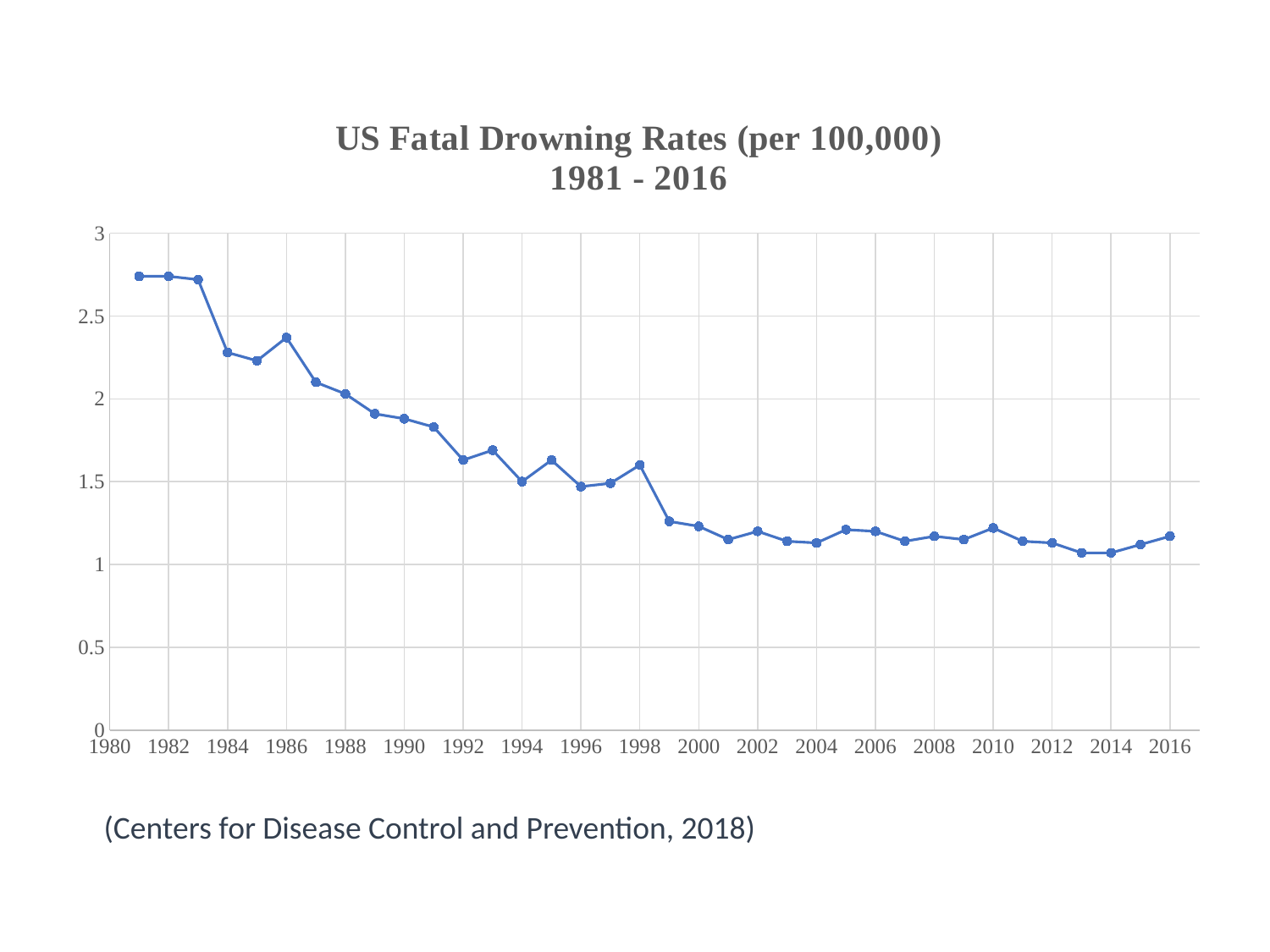
Which year has the larger value, 1981 or 2016? 1981 Is the value for 2014 greater or less than 1? greater What kind of chart is shown on the slide? line chart How many data points are plotted on the chart? 36 Is the value for 1990 greater or less than 2? less Is the value for 1986 greater or less than 2.5? less Which year has the larger value, 1998 or 1999? 1998 Do the fatal drowning rates generally rise or fall from 1981 to 2016? fall Which year has the larger value, 1985 or 1986? 1986 What is the title of the chart? US Fatal Drowning Rates (per 100,000) 1981 - 2016